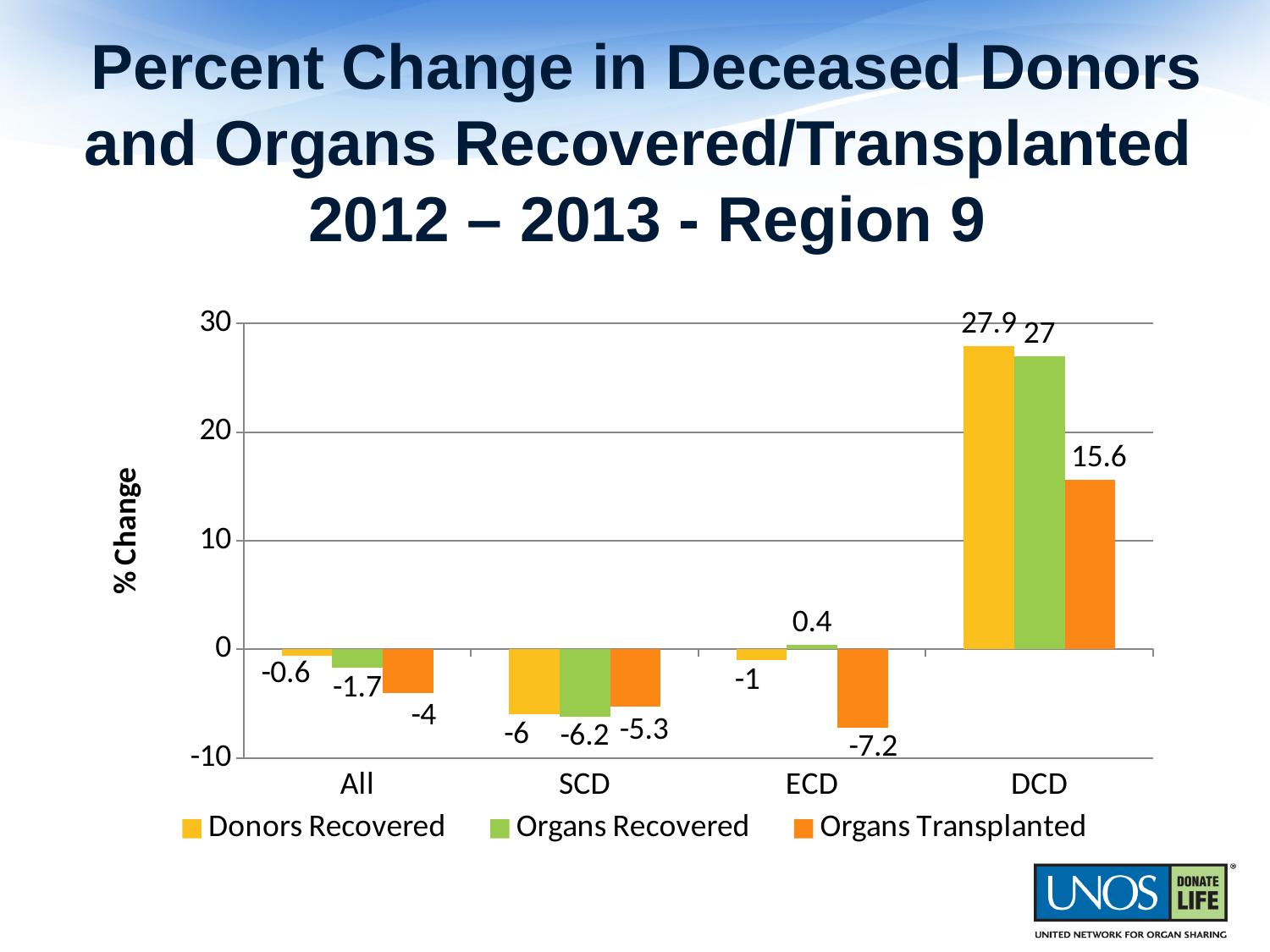
What is the difference between the Donors Recovered and Organs Transplanted percent changes for DCD? 12.3 What is the label on the vertical axis? % Change What kind of chart is shown on the slide? Bar chart What is the percent change in Donors Recovered for DCD? 27.9 Which is larger for ECD: the percent change in Organs Recovered or in Organs Transplanted? Organs Recovered Which category has the lowest percent change in Donors Recovered? SCD What is the percent change in Organs Transplanted for All? -4 Which category has the highest percent change in Organs Transplanted? DCD What is the percent change in Organs Recovered for SCD? -6.2 What is the percent change in Organs Transplanted for ECD? -7.2 How many categories are shown on the x axis? 4 How many series does the legend list? 3